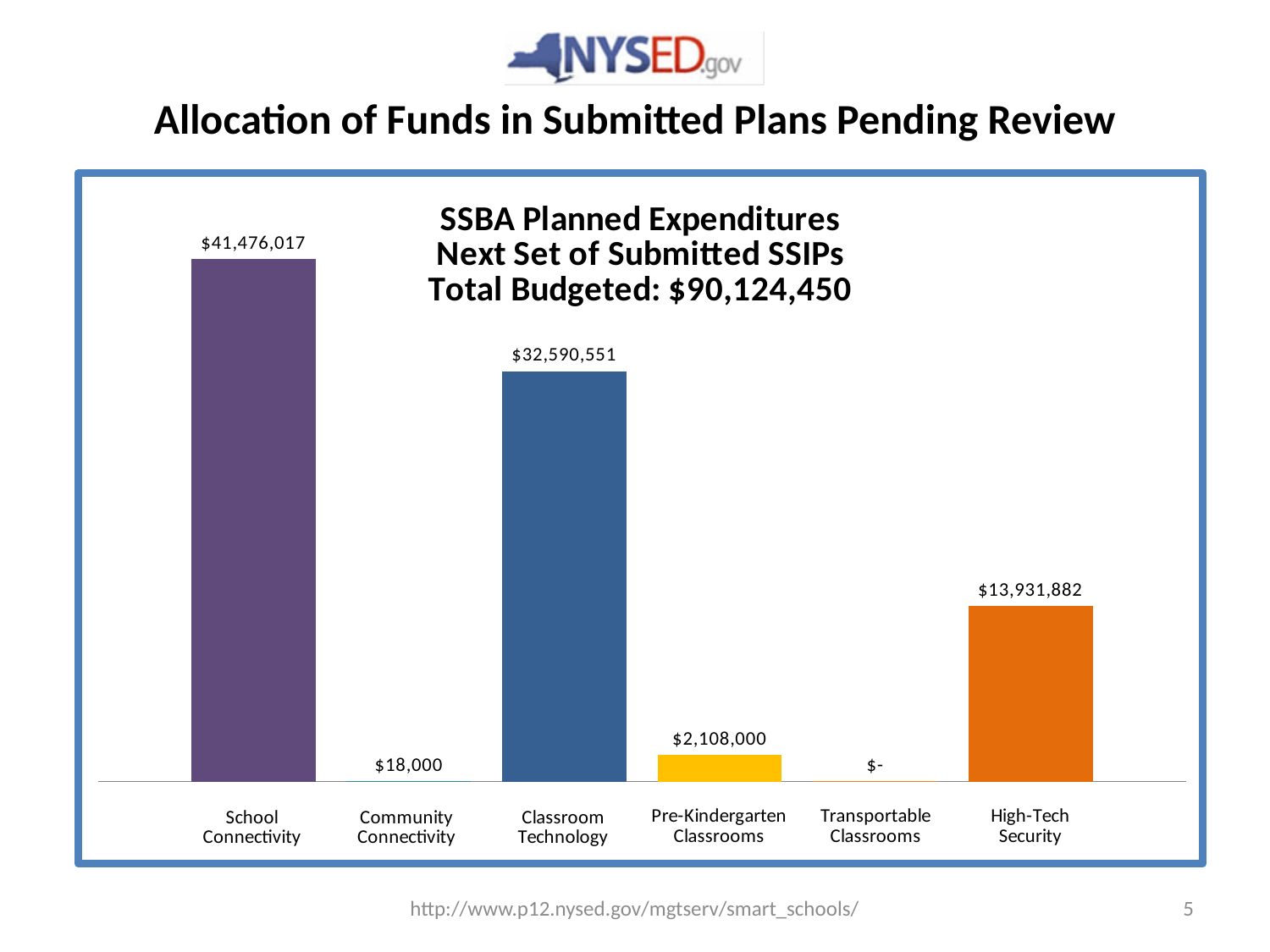
Which category has the highest planned expenditure? School Connectivity Which category has the lowest planned expenditure? Transportable Classrooms What is the planned expenditure for Community Connectivity? $18,000 Which is larger, the planned expenditure for High-Tech Security or for Pre-Kindergarten Classrooms? High-Tech Security How many categories are shown in the chart? 6 What is the planned expenditure for High-Tech Security? $13,931,882 What total budgeted amount is stated in the chart title? $90,124,450 What is the planned expenditure for Classroom Technology? $32,590,551 What is the planned expenditure for Pre-Kindergarten Classrooms? $2,108,000 What is the difference between the planned expenditures for School Connectivity and Classroom Technology? $8,885,466 What is the planned expenditure for School Connectivity? $41,476,017 What kind of chart is shown on the slide? Bar chart